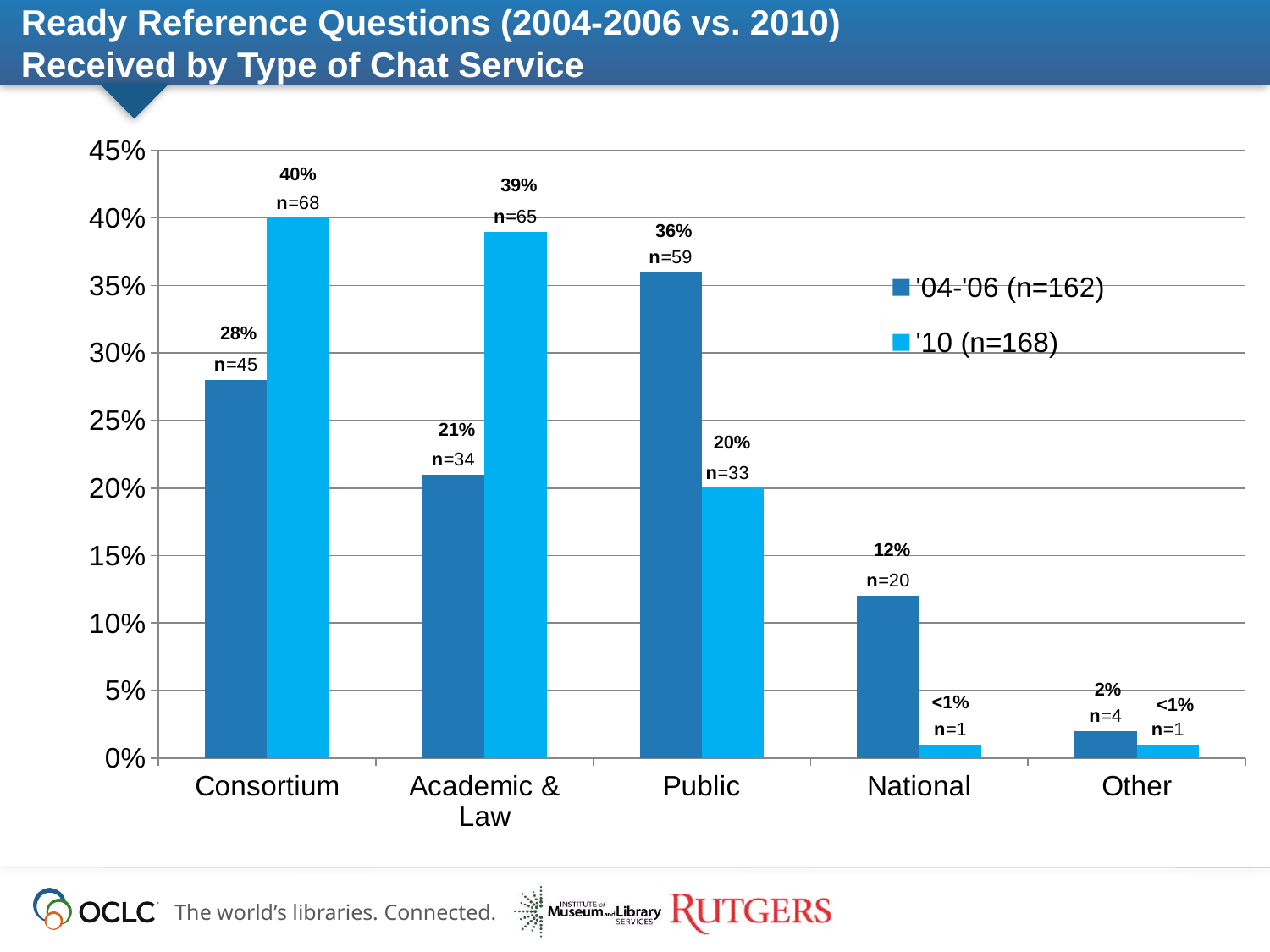
Which type of chat service has the highest percentage in the '10 series? Consortium What kind of chart is shown on the slide? Bar chart What percentage is shown for National in the '10 series? <1% What is the n value shown for Public in the '04-'06 series? n=59 What percentage of ready reference questions did Academic & Law chat services receive in '10? 39% What percentage of ready reference questions did Consortium chat services receive in '04-'06? 28% Which type of chat service has the lowest percentage in the '04-'06 series? Other How many series does the legend list? 2 What is the total sample size (n) for the '10 series according to the legend? 168 What is the difference in percentage points between the '10 and '04-'06 values for Consortium? 12 How many types of chat service are shown on the x axis? 5 For Public, which series has the larger value, '04-'06 or '10? '04-'06